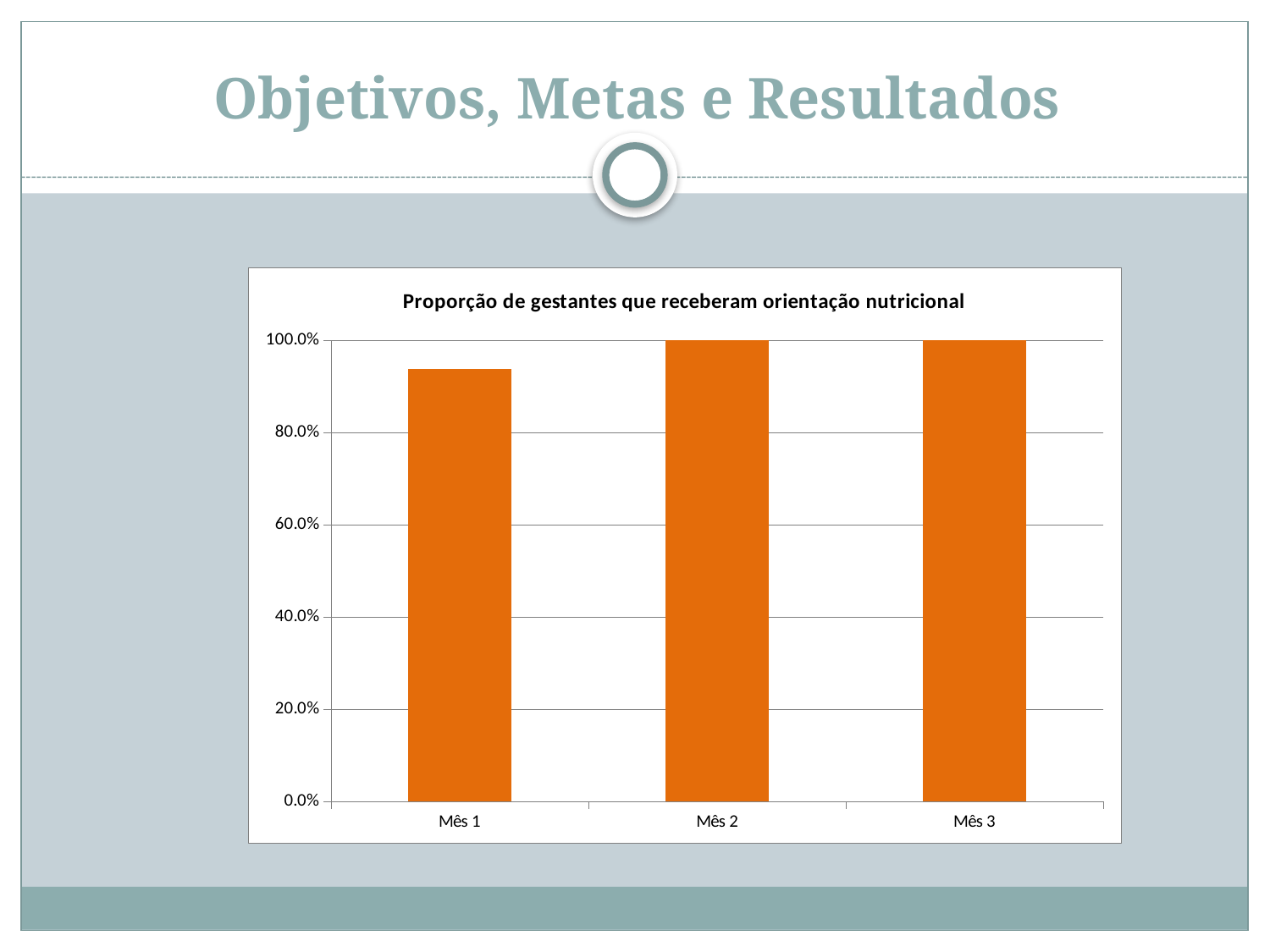
What kind of chart is shown on the slide? bar chart What is the value for Mês 2? 100.0% Which months reach 100.0%? Mês 2 and Mês 3 How many categories (months) are plotted on the x axis? 3 What is the value for Mês 3? 100.0% Which is larger, the value for Mês 1 or the value for Mês 2? Mês 2 What is the title of the chart? Proporção de gestantes que receberam orientação nutricional Is the value for Mês 1 greater or less than 100.0%? less Do the values rise or fall from Mês 1 to Mês 2? rise Is the value for Mês 1 greater or less than 80.0%? greater Which month has the lowest value? Mês 1 What colour are the bars in the chart? orange